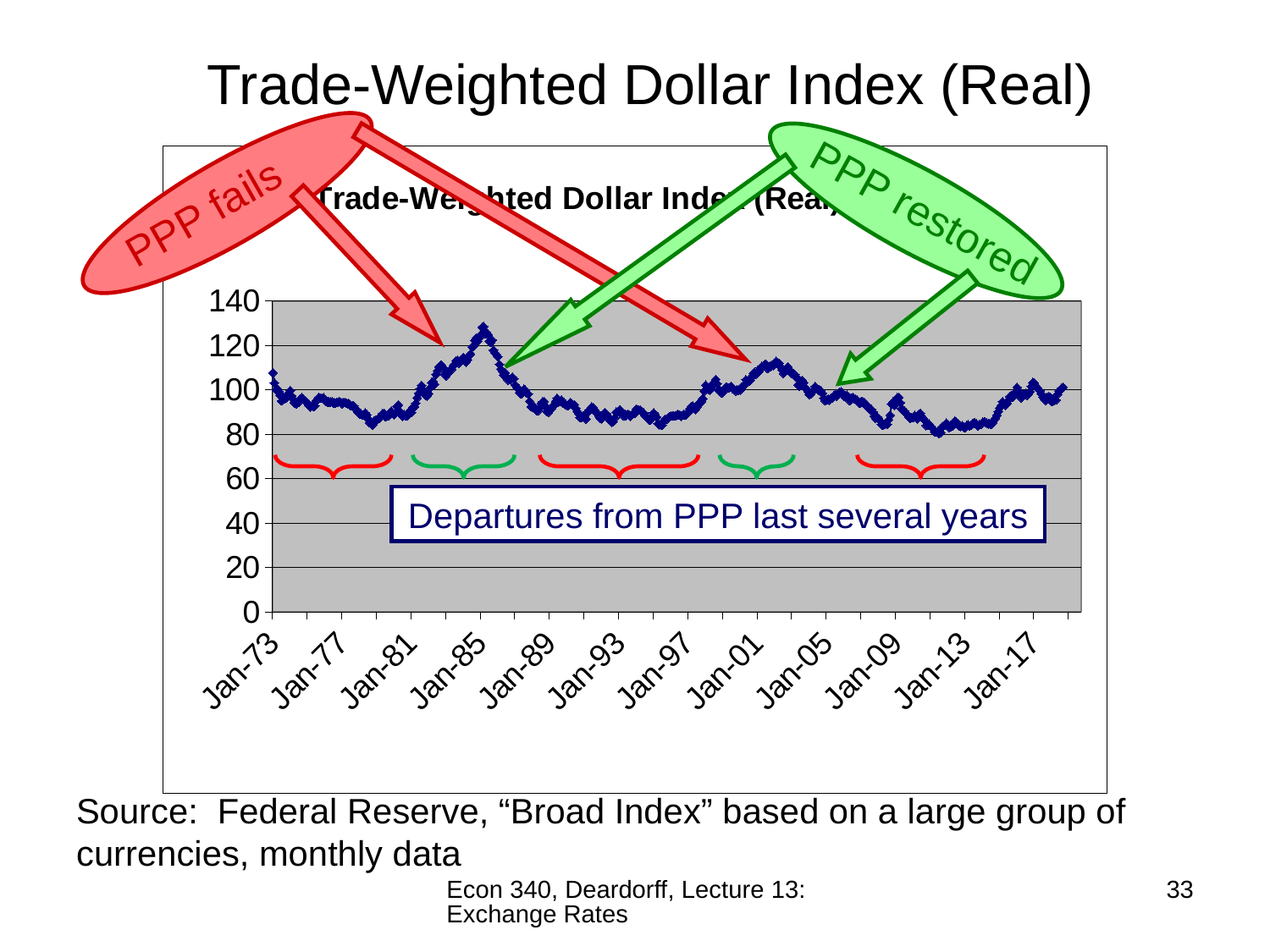
Does the series rise or fall between Jan-81 and Jan-85? rise What is the highest value shown on the y axis of the chart? 140 Does the series rise or fall between Jan-85 and Jan-89? fall Is the highest point of the series greater or less than 120? greater Is the lowest point of the series greater or less than 100? less Is the value at Jan-93 greater or less than 100? less Near which x-axis label does the series reach its highest value? Jan-85 What is the title of the chart? Trade-Weighted Dollar Index (Real) How many year labels are shown along the x axis of the chart? 12 What kind of chart is shown on the slide? line chart